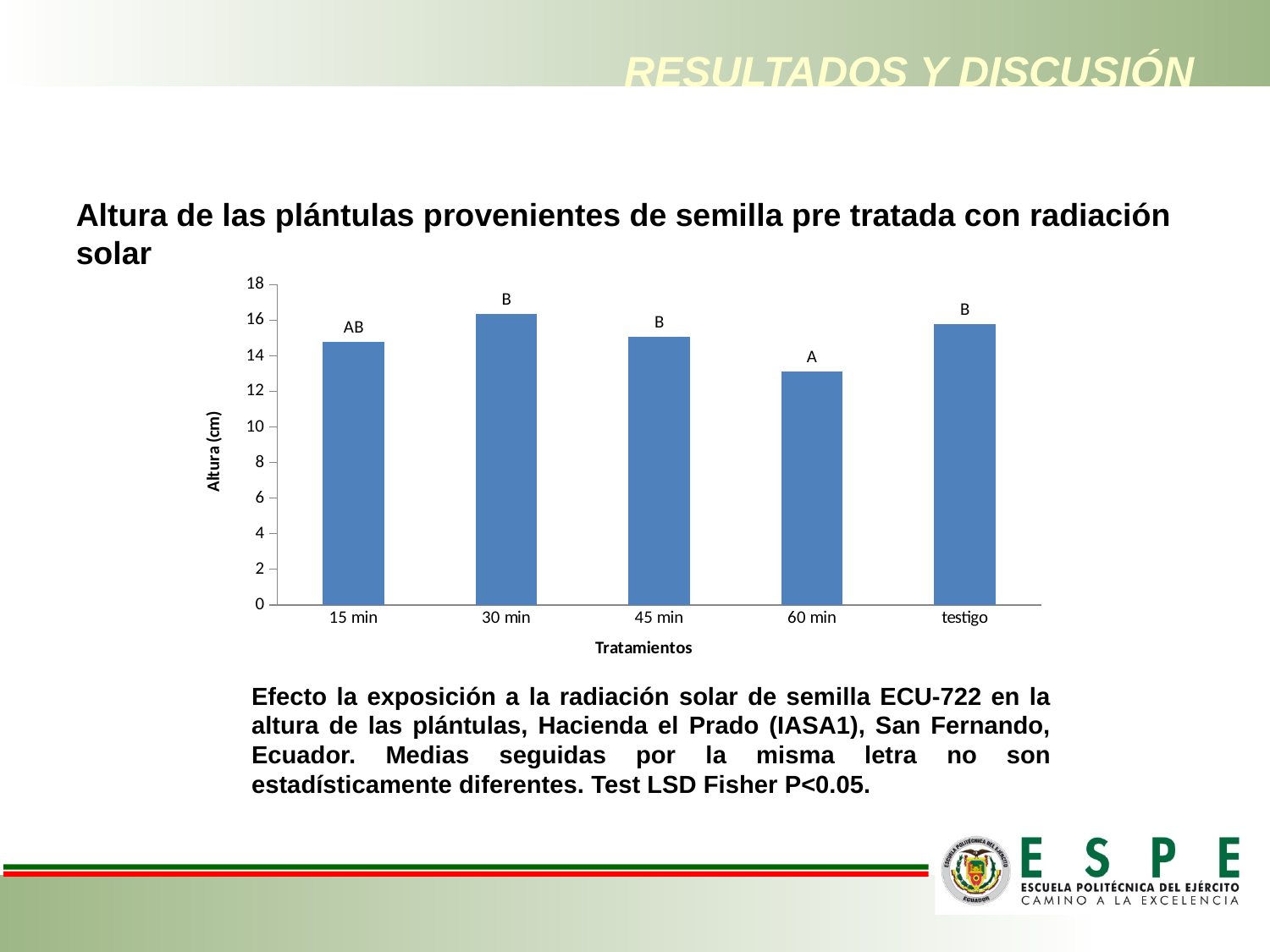
What kind of chart is shown on the slide? bar chart Is the value for 60 min greater or less than 14? less Which is larger, the value for testigo or the value for 15 min? testigo Is the value for 15 min greater or less than 14? greater Which is larger, the value for 30 min or the value for 60 min? 30 min What letter label appears above the 60 min bar? A Which treatment has the tallest bar? 30 min Is the value for 30 min greater or less than 16? greater How many treatments (categories) are shown on the x axis? 5 Which treatment has the shortest bar? 60 min What is the title of the y axis? Altura (cm)